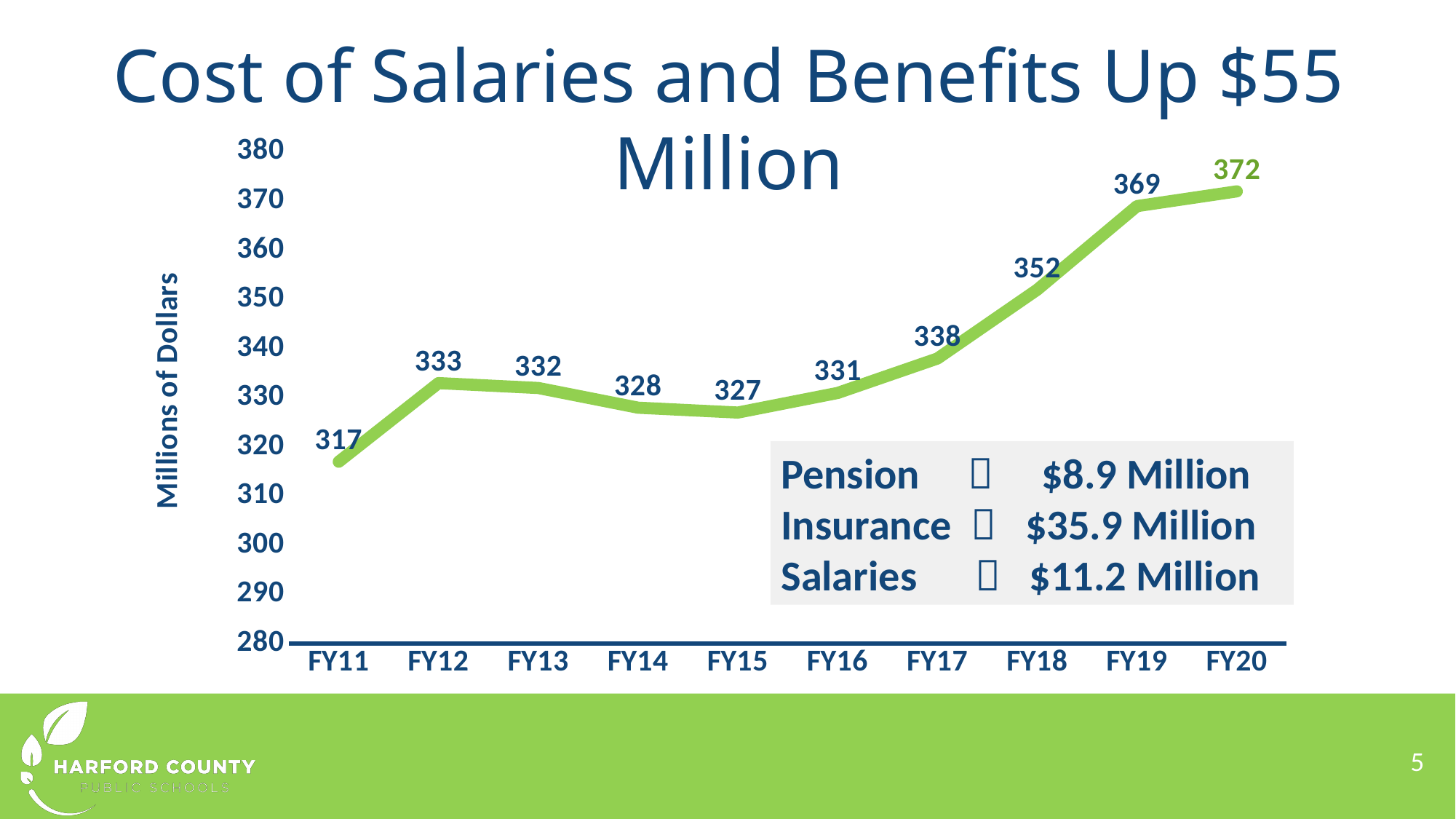
What is the label on the vertical axis of the chart? Millions of Dollars What is the difference between the FY19 value and the FY18 value? 17 What is the value for FY20? 372 How many fiscal years are plotted on the chart? 10 Which is larger, the value for FY12 or the value for FY16? FY12 What is the difference between the FY20 value and the FY11 value? 55 Which fiscal year has the highest value? FY20 Which fiscal year has the lowest value? FY11 Do the values rise or fall from FY15 to FY20? Rise What is the value for FY11? 317 What kind of chart is shown on the slide? Line chart What is the value for FY15? 327